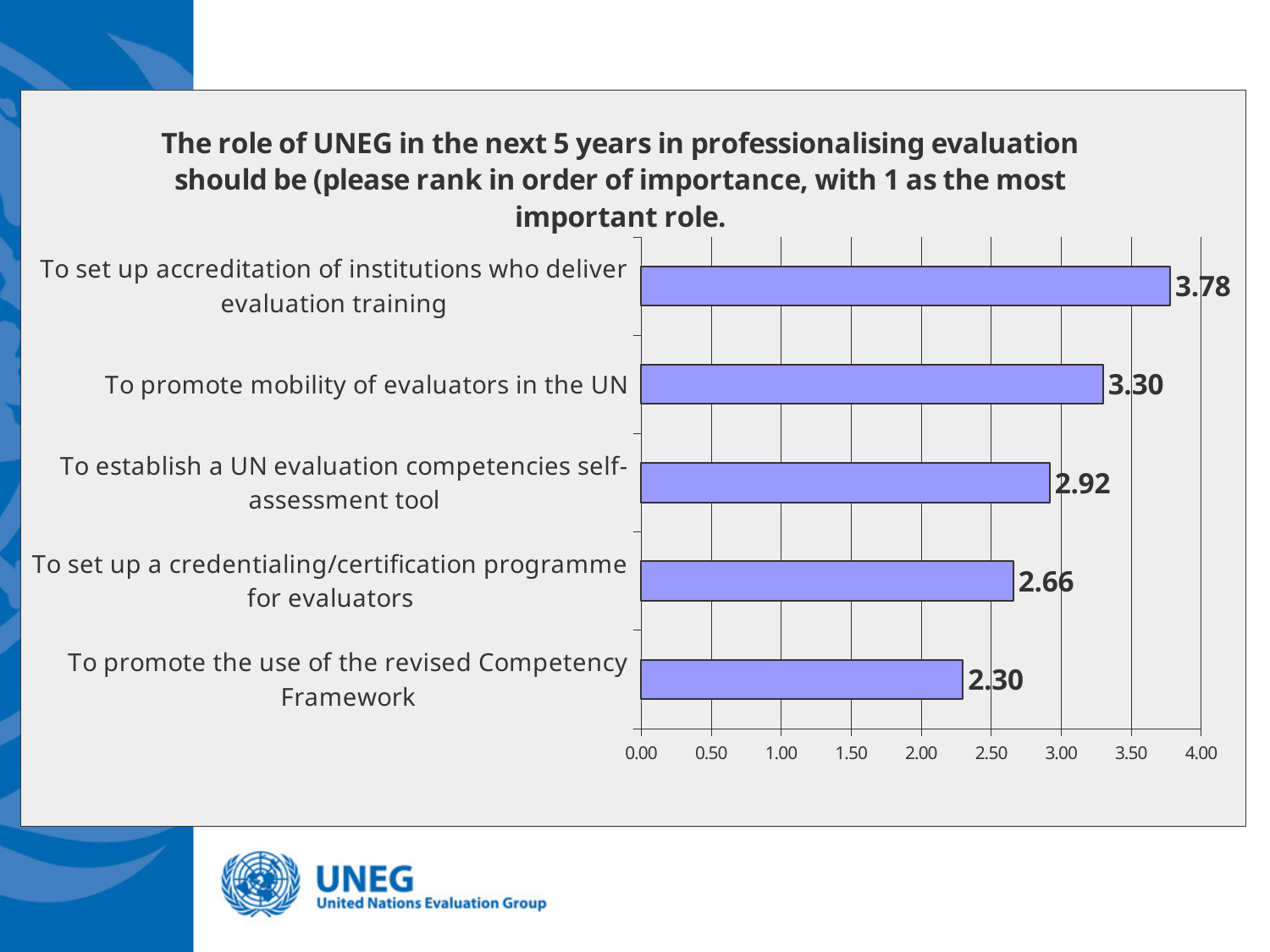
Which category has the highest value? To set up accreditation of institutions who deliver evaluation training Which is larger: the value for "To establish a UN evaluation competencies self-assessment tool" or for "To set up a credentialing/certification programme for evaluators"? To establish a UN evaluation competencies self-assessment tool Which category has the lowest value? To promote the use of the revised Competency Framework What kind of chart is shown on the slide? Bar chart What is the maximum value shown on the horizontal axis? 4.00 What is the value for "To set up accreditation of institutions who deliver evaluation training"? 3.78 What is the value for "To promote mobility of evaluators in the UN"? 3.30 Is the value for "To promote mobility of evaluators in the UN" greater or less than 3.00? greater How many categories are shown in the chart? 5 What is the value for "To promote the use of the revised Competency Framework"? 2.30 What is the value for "To establish a UN evaluation competencies self-assessment tool"? 2.92 What is the difference between the values for "To set up accreditation of institutions who deliver evaluation training" and "To promote the use of the revised Competency Framework"? 1.48